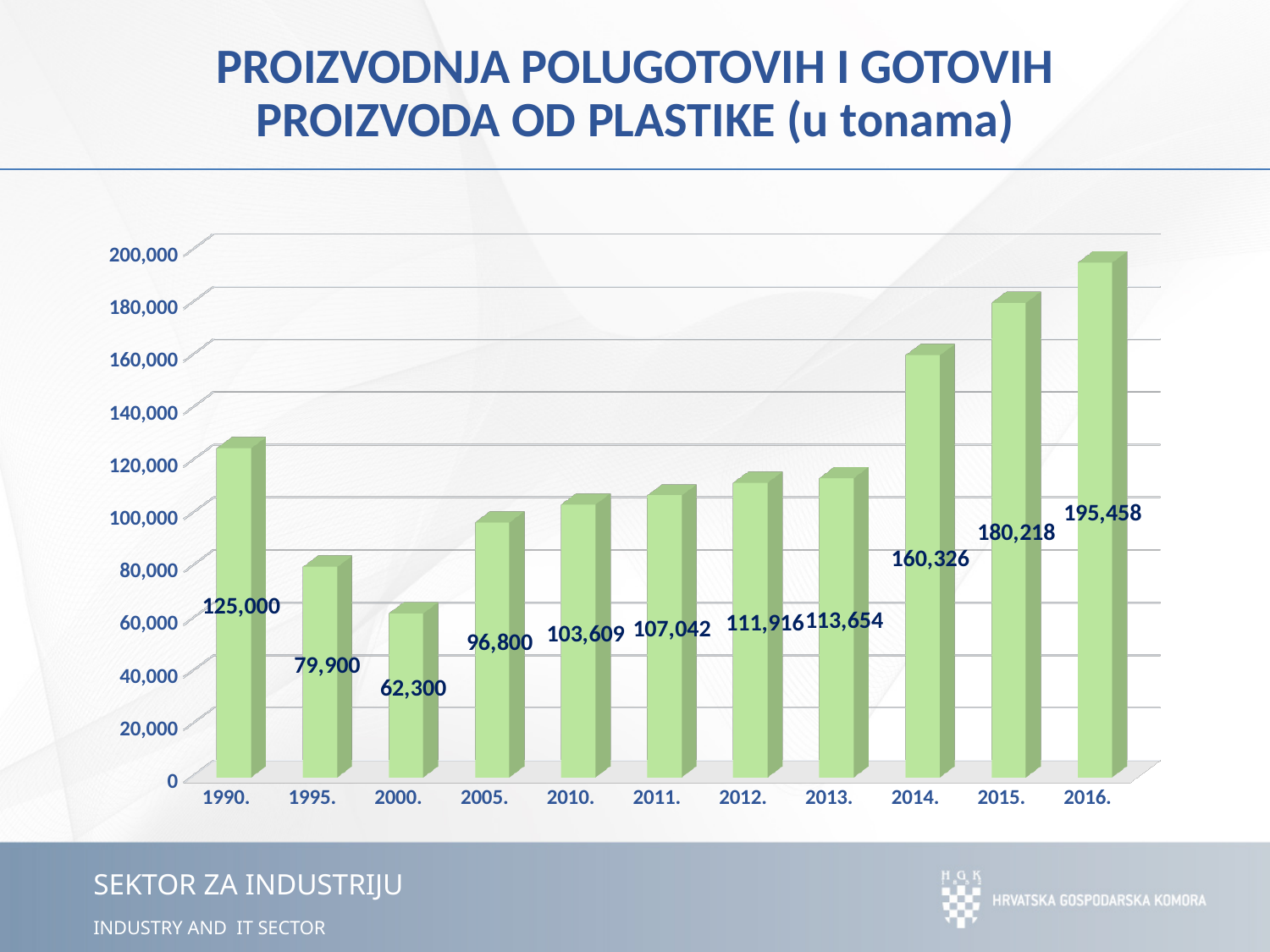
What is the production value for 2016? 195,458 Which is larger, the value for 1995 or the value for 2005? 2005. What is the difference between the values for 2016 and 2015? 15,240 Do the values rise or fall from 2005 to 2016? rise Is the value for 2014 greater or less than 140,000? greater What is the production value for 1990? 125,000 What is the difference between the values for 1990 and 2000? 62,700 What is the production value for 2005? 96,800 What kind of chart is shown on the slide? bar chart How many years are shown on the x axis? 11 Which year has the lowest production value? 2000. Which year has the highest production value? 2016.